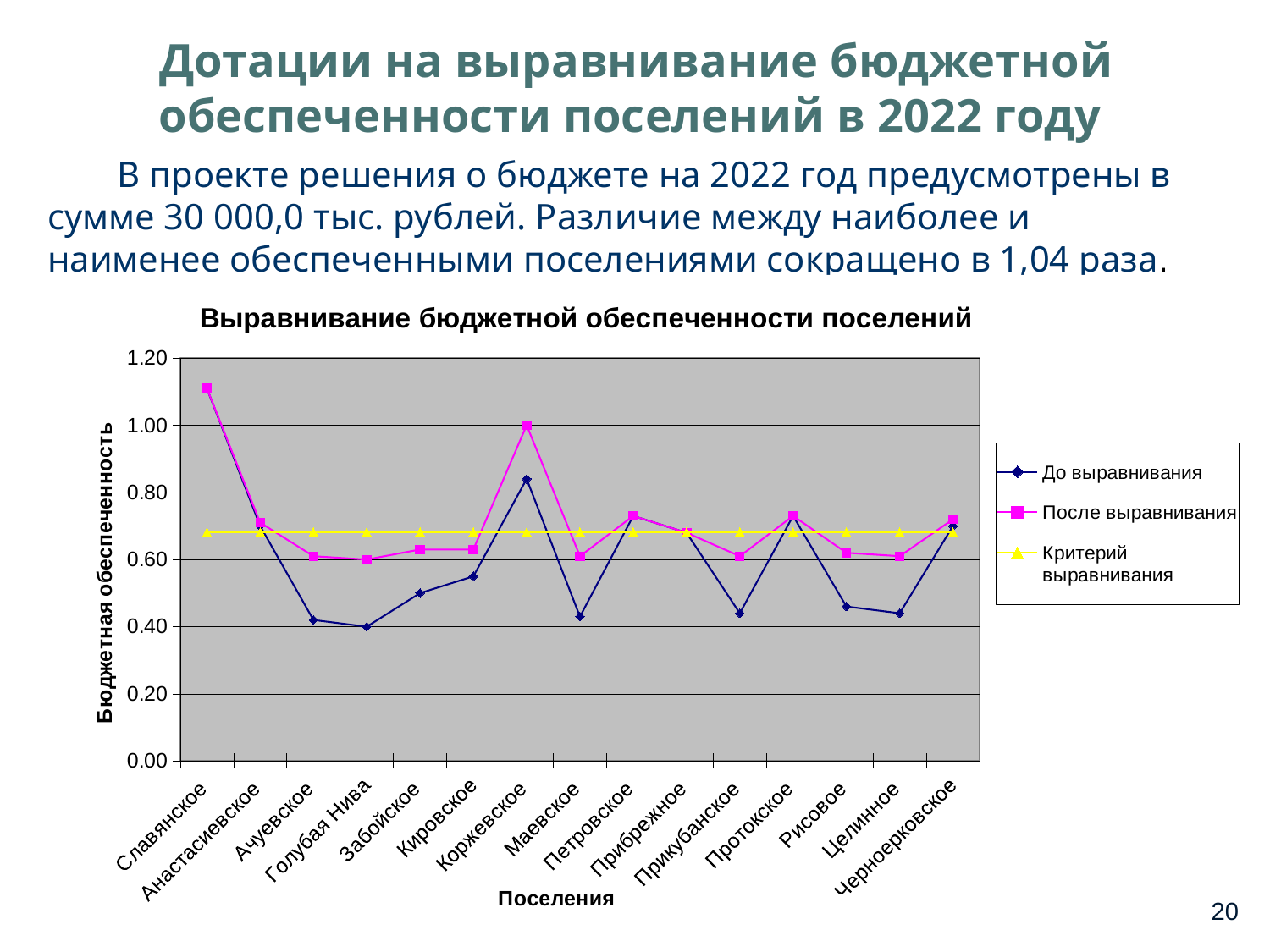
Which is larger for Маевское: the 'До выравнивания' value or the 'После выравнивания' value? После выравнивания How many series does the legend list? 3 Which settlement has the highest value for the 'После выравнивания' series? Славянское What is the title of the chart? Выравнивание бюджетной обеспеченности поселений Which settlement has the lowest value for the 'До выравнивания' series? Голубая Нива Which settlement has the highest value for the 'До выравнивания' series? Славянское How many settlements (categories) are plotted along the x axis? 15 Is the 'До выравнивания' value for Коржевское greater or less than 0.80? greater Is the 'После выравнивания' value for Славянское greater or less than 1.00? greater Does the 'Критерий выравнивания' series rise, fall, or stay flat across the settlements? stays flat What kind of chart is shown on the slide? line chart Is the 'До выравнивания' value for Ачуевское greater or less than 0.60? less